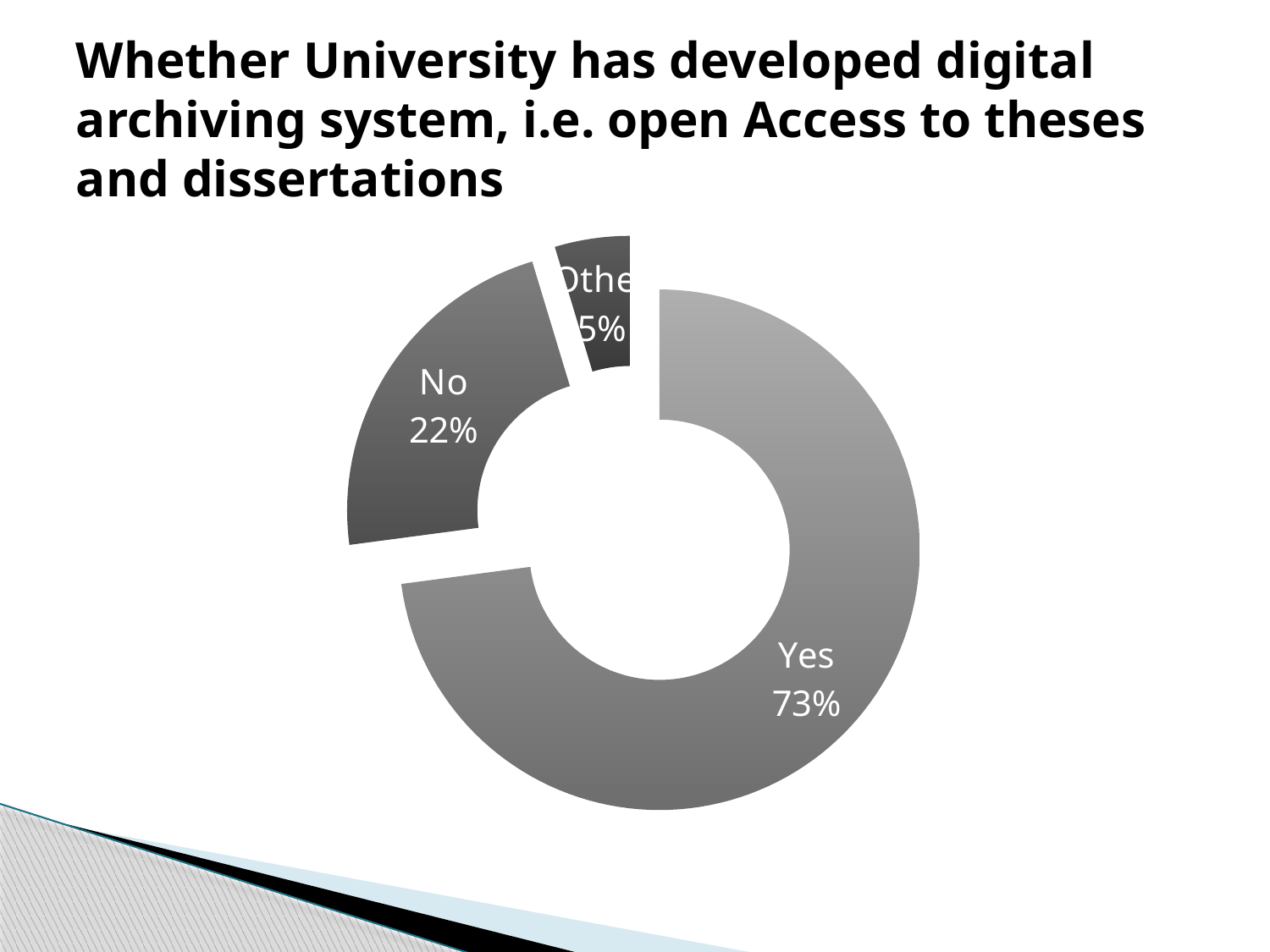
What kind of chart is shown on the slide? doughnut (pie) chart What is the combined share of the Yes and No slices? 95% Which response has the largest share of the chart? Yes What percentage of respondents answered No? 22% Is the share for Yes greater or less than 50%? greater How many slices does the chart have? 3 What percentage of respondents answered Yes? 73% Which is larger, the share for Yes or the share for No? Yes What is the difference in percentage points between the Yes and No shares? 51 What is the title of the slide? Whether University has developed digital archiving system, i.e. open Access to theses and dissertations